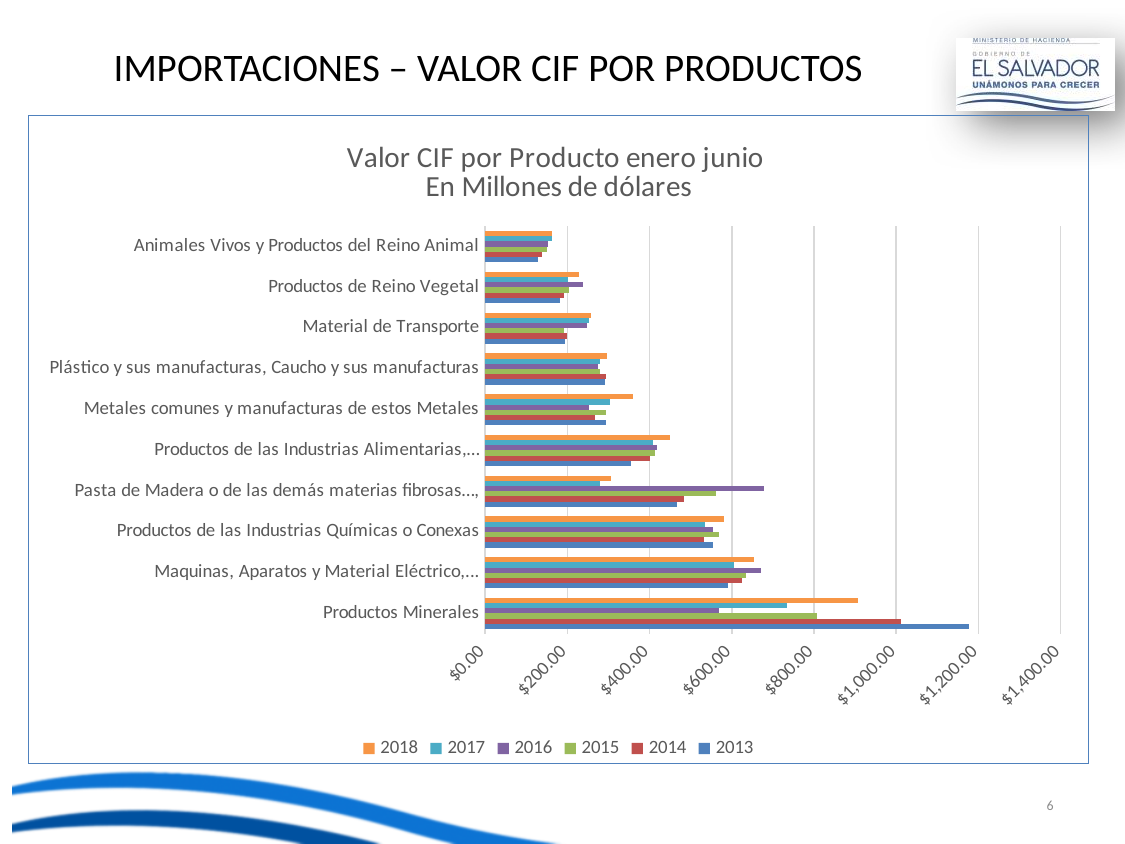
Is the 2018 value for Productos Minerales greater or less than $800.00? greater How many product categories are listed on the chart? 10 Which product category has the highest value on the chart? Productos Minerales Is the 2018 value for Animales Vivos y Productos del Reino Animal greater or less than $200.00? less Which year is listed first in the chart legend? 2018 What is the title of the chart? Valor CIF por Producto enero junio En Millones de dólares Which product category has the lowest values on the chart? Animales Vivos y Productos del Reino Animal For Productos Minerales, which is larger: the 2013 value or the 2018 value? 2013 Is the 2013 value for Productos Minerales greater or less than $1,000.00? greater What kind of chart is shown on the slide? bar chart How many series does the legend list? 6